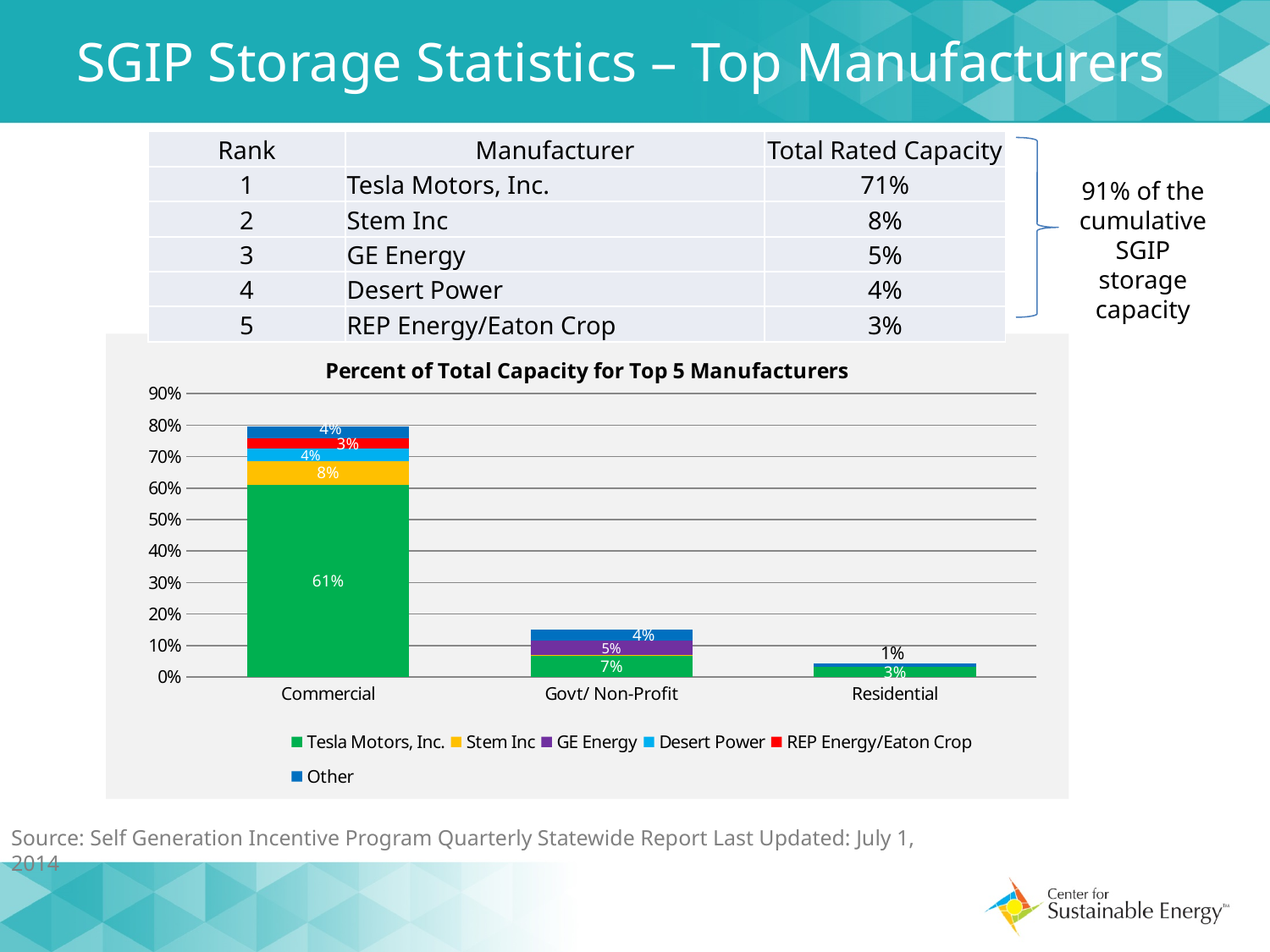
What is the total of the Govt/ Non-Profit stacked bar? 16% What is the value for Stem Inc in the Commercial category? 8% Which category has the tallest stacked bar? Commercial What is the value for Tesla Motors, Inc. in the Residential category? 3% What is the value for GE Energy in the Govt/ Non-Profit category? 5% How many series does the legend list? 6 What is the value for Tesla Motors, Inc. in the Commercial category? 61% What is the difference between the Tesla Motors, Inc. value for Commercial and for Govt/ Non-Profit? 54% Is the total of the Commercial stacked bar greater or less than 70%? greater How many categories are shown on the x axis? 3 What kind of chart is shown on the slide? Stacked bar chart Which category has the shortest stacked bar? Residential